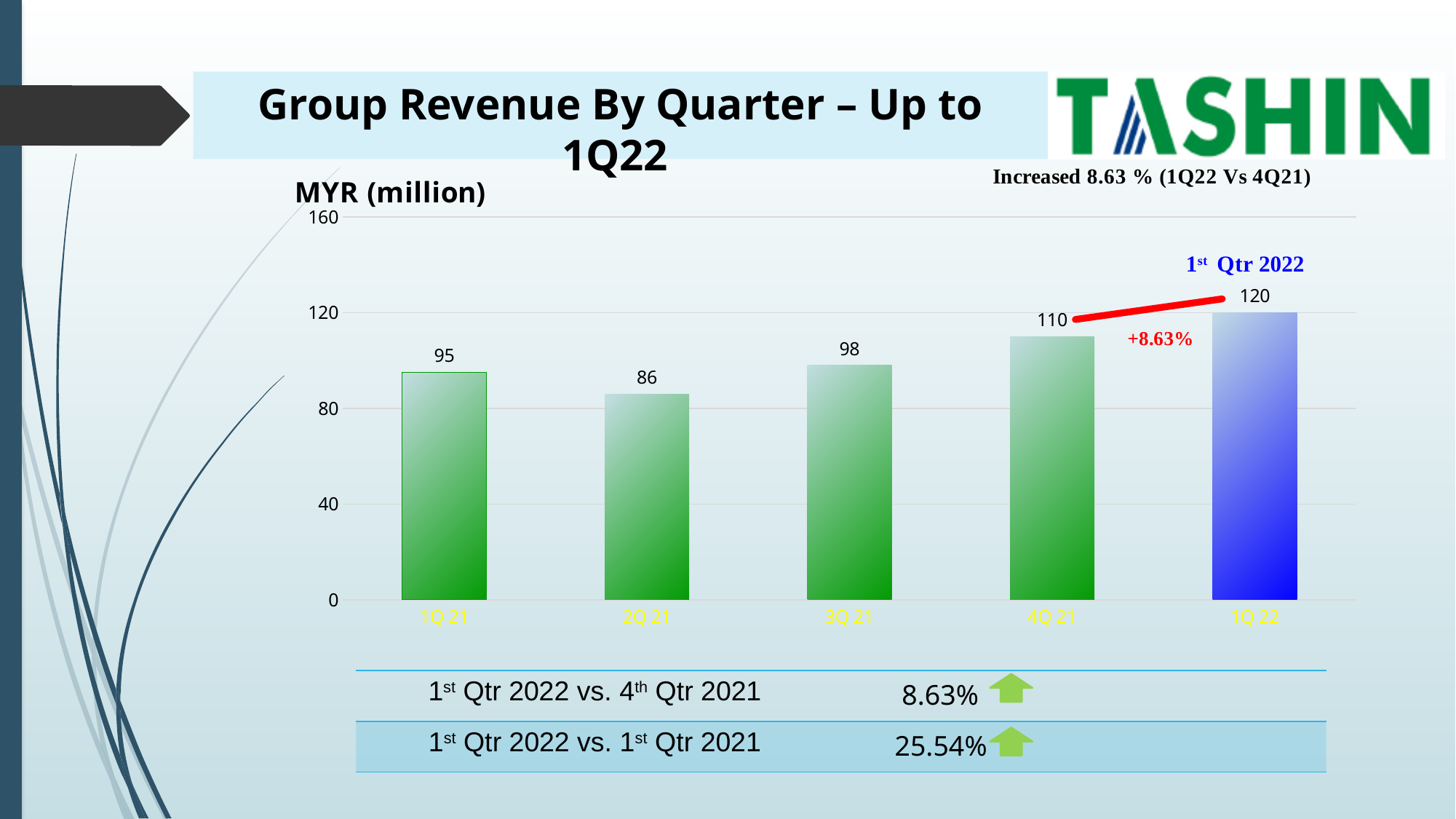
What is the group revenue for 2Q 21? 86 What is the difference in revenue between 3Q 21 and 2Q 21? 12 What is the group revenue for 4Q 21? 110 Which quarter has higher revenue, 1Q 21 or 3Q 21? 3Q 21 Which quarter has the highest revenue? 1Q 22 What unit is shown on the y axis of the chart? MYR (million) How many quarters are shown in the chart? 5 What is the group revenue for 1Q 21? 95 Which quarter has the lowest revenue? 2Q 21 What is the group revenue for 1Q 22? 120 What kind of chart is shown on the slide? Bar chart What is the difference in revenue between 1Q 22 and 4Q 21? 10